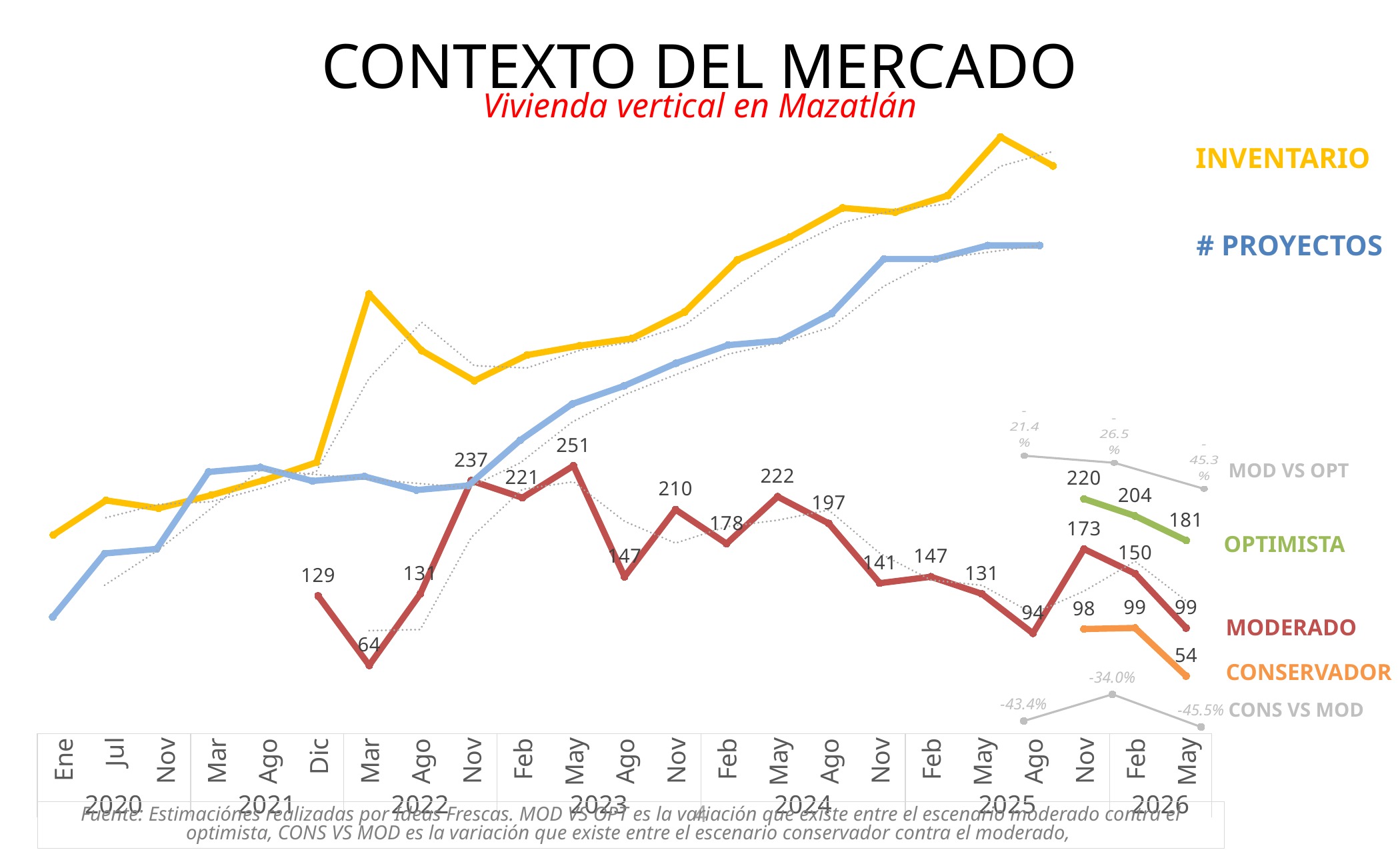
What is the difference between the OPTIMISTA and MODERADO values in Nov 2025? 47 What is the OPTIMISTA value for May 2026? 181 What is the MODERADO value for May 2023? 251 In which month and year does the MODERADO series reach its lowest labelled value? Mar 2022 What is the MOD VS OPT value for May 2026? -45.3% How many data points does the OPTIMISTA series have? 3 In Feb 2026, which is larger: the MODERADO value or the CONSERVADOR value? MODERADO What is the CONSERVADOR value for May 2026? 54 In which month and year does the MODERADO series reach its highest labelled value? May 2023 What kind of chart is shown on the slide? line chart What is the CONS VS MOD value for Feb 2026? -34.0% Does the # PROYECTOS line generally rise or fall from Ene 2020 to May 2026? rise